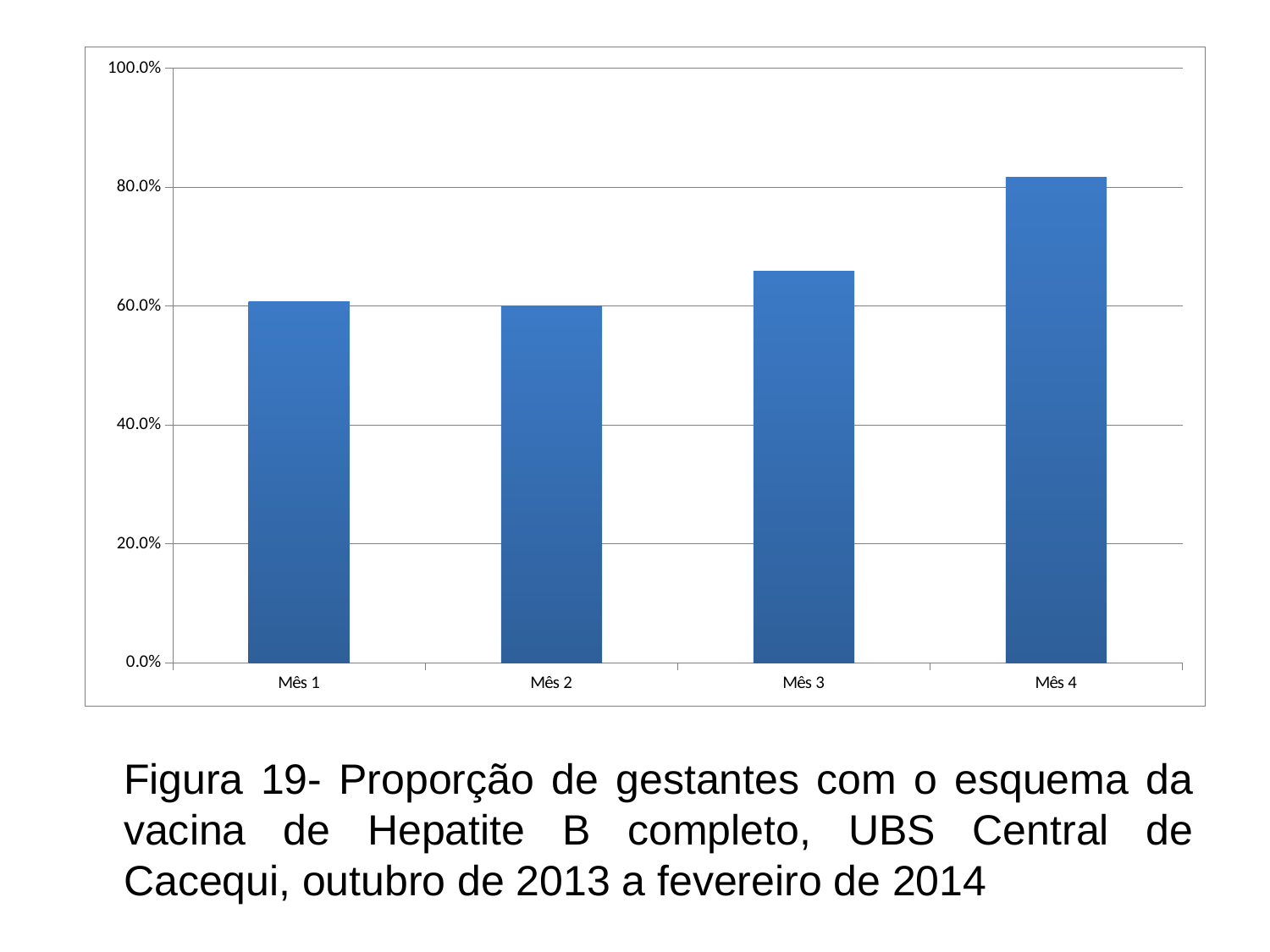
Is the value for Mês 4 greater or less than 80.0%? greater Is the value for Mês 2 greater or less than 40.0%? greater Which is larger, the value for Mês 4 or the value for Mês 3? Mês 4 What figure number is given in the caption below the chart? Figura 19 Which is larger, the value for Mês 3 or the value for Mês 1? Mês 3 From Mês 2 to Mês 4, do the values rise or fall? rise What kind of chart is shown on the slide? bar chart How many categories (months) are shown on the x axis? 4 Is the value for Mês 1 greater or less than 80.0%? less Which month has the highest proportion? Mês 4